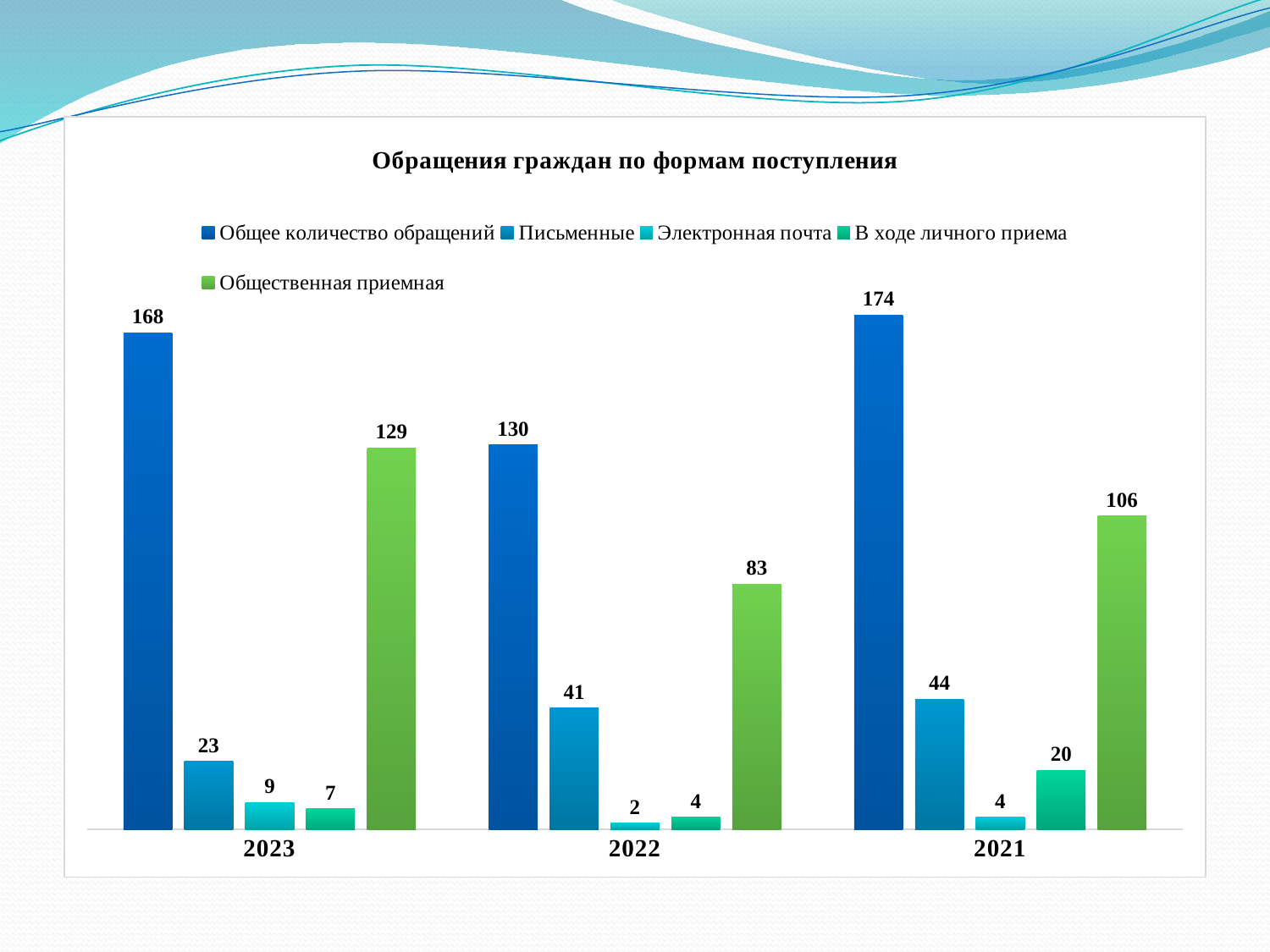
What is the value of 'Письменные' for 2022? 41 How many years are shown on the x axis? 3 How many series does the legend list? 5 Which year has the highest value for 'Общее количество обращений'? 2021 What is the title of the chart? Обращения граждан по формам поступления What is the value of 'Общественная приемная' for 2021? 106 What is the value of 'В ходе личного приема' for 2021? 20 What kind of chart is shown on the slide? Bar chart Which is larger: 'Общественная приемная' in 2023 or in 2021? 2023 Which year has the lowest value for 'Электронная почта'? 2022 What is the value of 'Общее количество обращений' for 2023? 168 What is the difference between 'Общее количество обращений' in 2021 and in 2022? 44